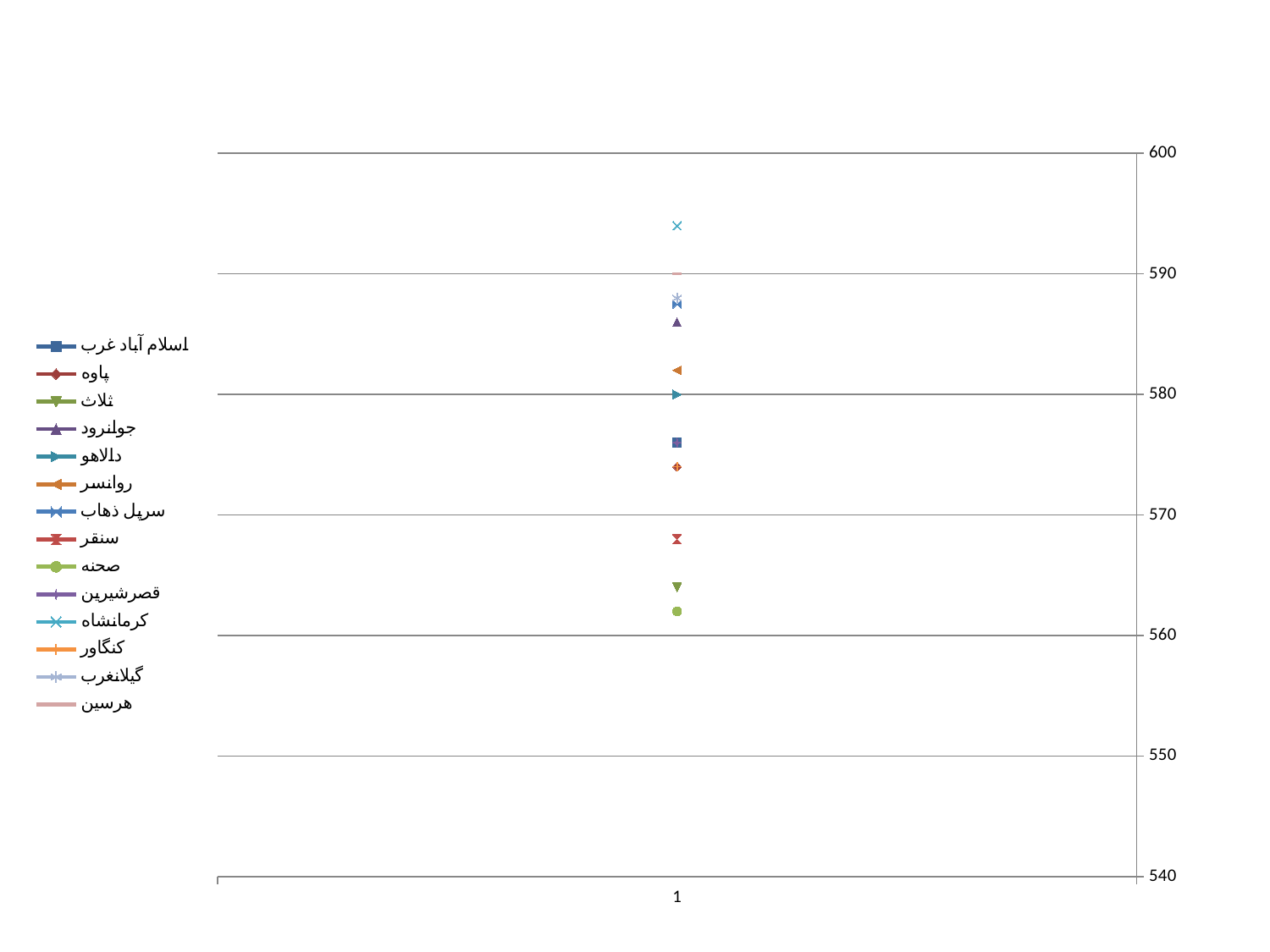
Is the value for اسلام آباد غرب greater or less than 580? less What is the highest value shown on the y axis? 600 Which series has the lowest plotted value? صحنه Is the value for ثلاث greater or less than 570? less Which is larger, the value for سنقر or the value for روانسر? روانسر Which series has the highest plotted value? کرمانشاه Is the value for جوانرود greater or less than 580? greater What kind of chart is shown on the slide? line chart How many series does the legend list? 14 How many categories are shown on the x axis? 1 Which is larger, the value for جوانرود or the value for پاوه? جوانرود